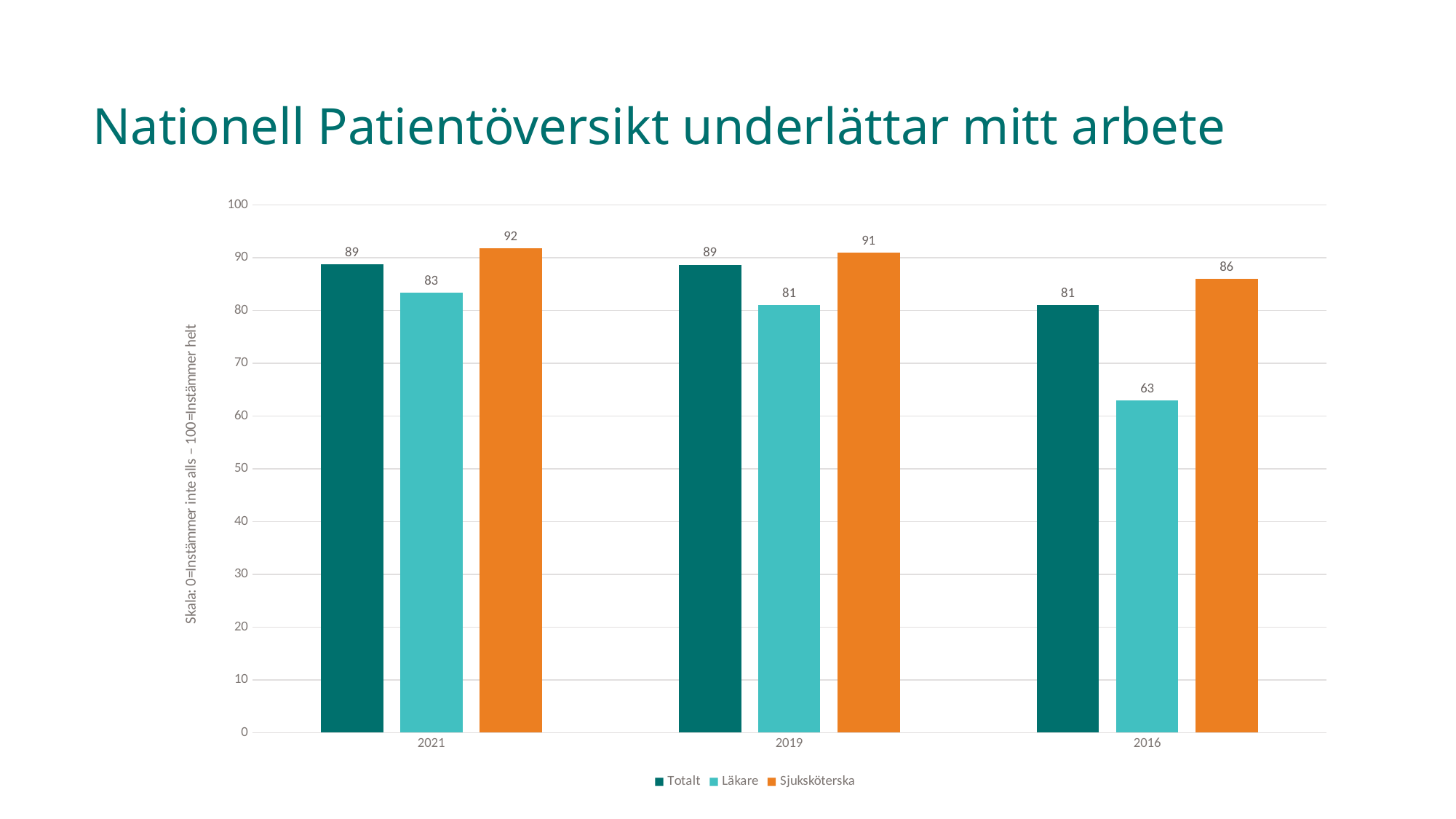
What is the difference between the Sjuksköterska and Läkare values in 2016? 23 Which year has the lowest value for Läkare? 2016 What is the title of the chart? Nationell Patientöversikt underlättar mitt arbete Which is larger, the Totalt value in 2021 or the Totalt value in 2016? 2021 What is the value for Sjuksköterska in 2021? 92 What is the value for Totalt in 2019? 89 What is the value for Läkare in 2016? 63 Is the value for Läkare in 2016 greater or less than 70? less What kind of chart is shown on the slide? bar chart How many year categories are shown on the x axis? 3 Which series has the highest value in 2019? Sjuksköterska How many series does the legend list? 3